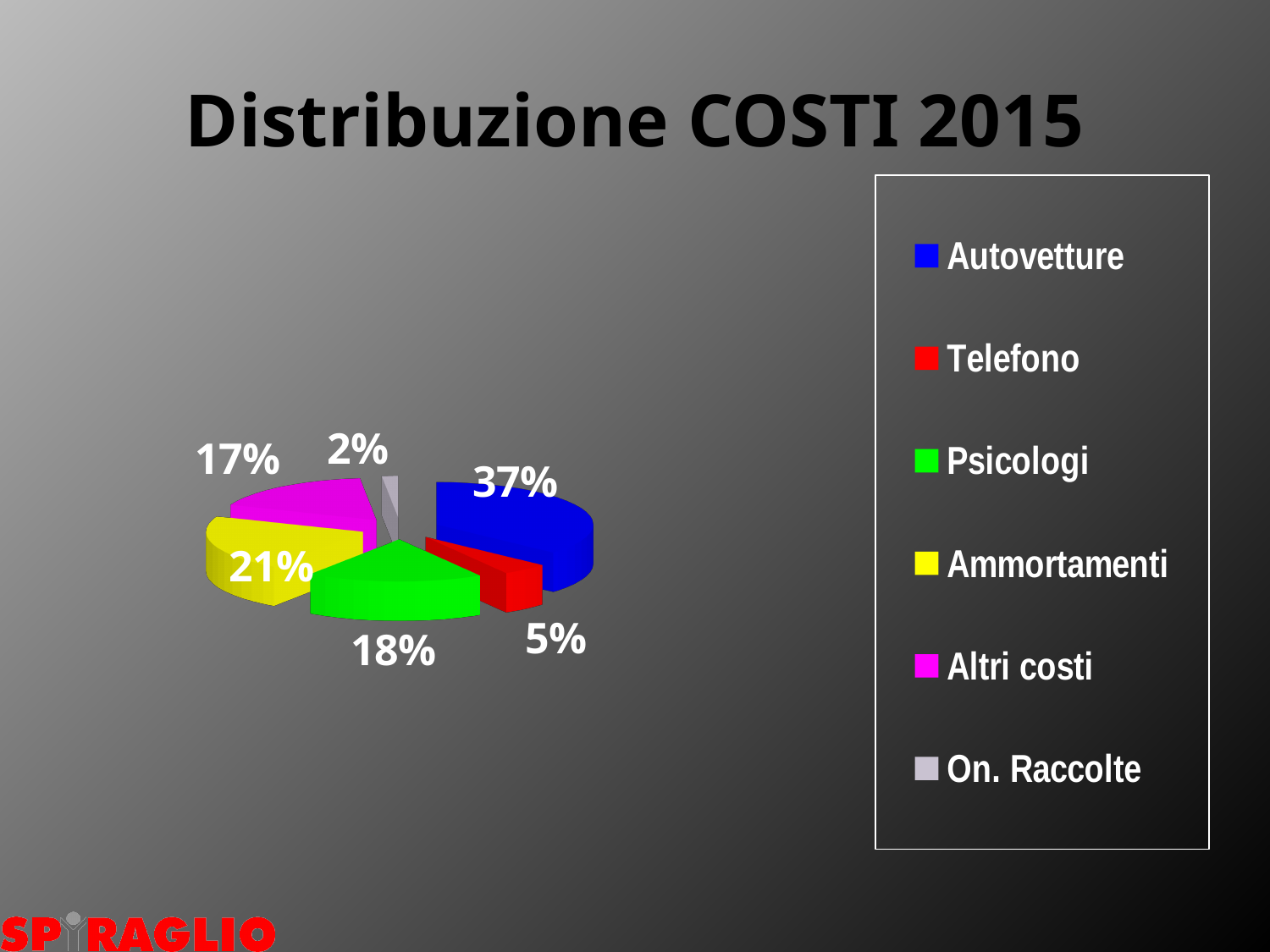
What percentage is shown for Telefono? 5% How many categories does the pie chart have? 6 What percentage is shown for Psicologi? 18% Which is larger, the share for Psicologi or the share for Altri costi? Psicologi Which category has the smallest share of the pie? On. Raccolte What share of costs does Autovetture account for? 37% What percentage is shown for On. Raccolte? 2% What share of costs does Ammortamenti represent? 21% What is the difference in percentage points between Autovetture and Ammortamenti? 16 Which category has the largest share of the pie? Autovetture What is the title of the chart? Distribuzione COSTI 2015 What kind of chart is shown on the slide? pie chart